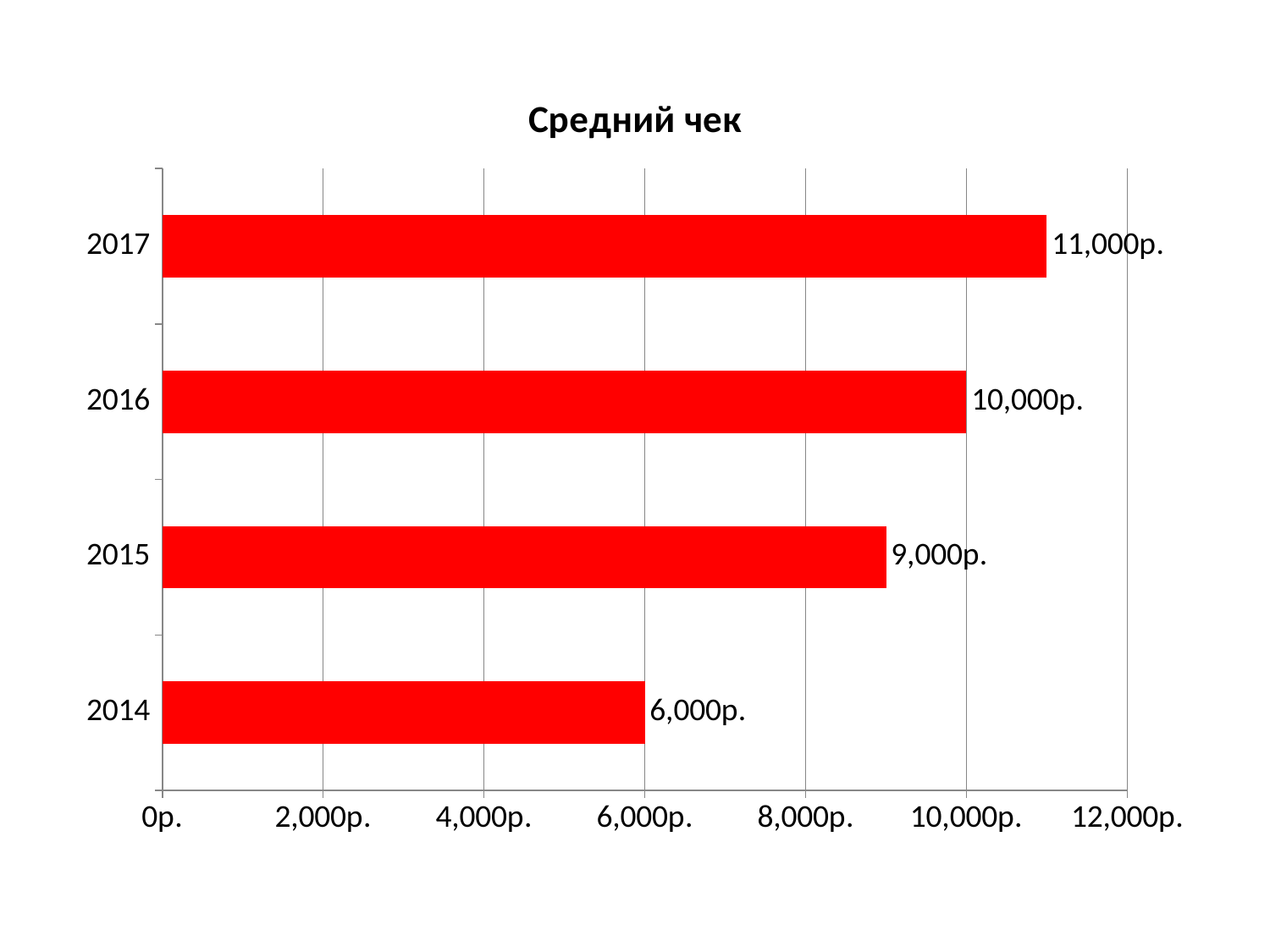
What is the value for 2017? 11,000р. What is the value for 2015? 9,000р. What is the value for 2014? 6,000р. How many years are shown in the chart? 4 What is the difference between the values for 2017 and 2014? 5,000р. Which is larger, the value for 2016 or the value for 2015? 2016 What kind of chart is this? bar chart Which year has the lowest value? 2014 What is the title of the chart? Средний чек Which year has the highest value? 2017 Is the value for 2015 greater or less than 8,000р.? greater What is the difference between the values for 2016 and 2015? 1,000р.